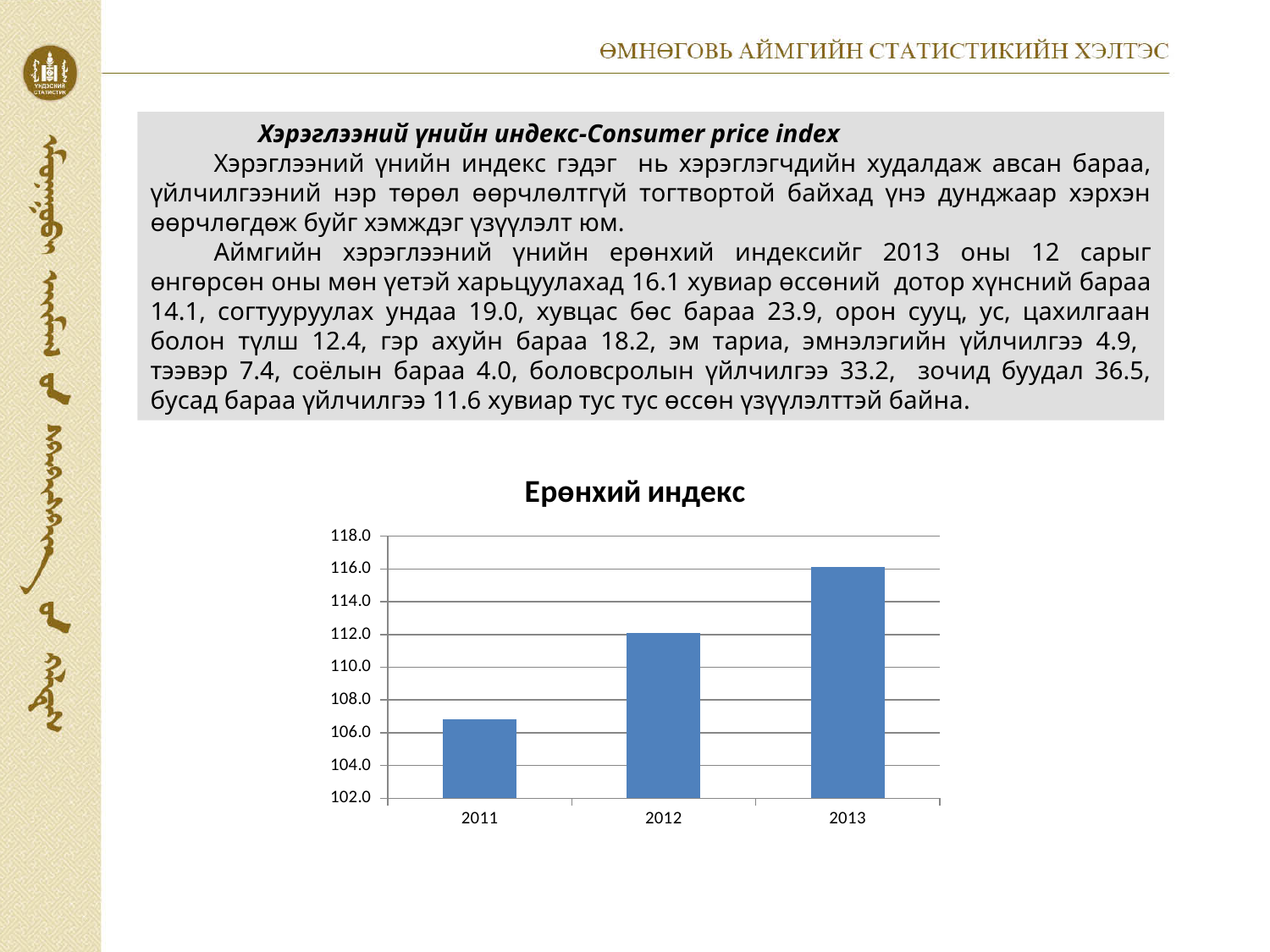
What is the lowest value shown on the vertical axis of the chart? 102.0 Do the values rise or fall from 2011 to 2013? rise Which year has the highest value on the chart? 2013 What is the title of the chart? Ерөнхий индекс Is the value for 2012 greater or less than 110.0? greater What kind of chart is shown on the slide? bar chart Which year has the lowest value on the chart? 2011 Is the value for 2013 greater or less than 114.0? greater Which is larger, the value for 2012 or the value for 2013? 2013 Is the value for 2011 greater or less than 106.0? greater How many years are plotted on the chart? 3